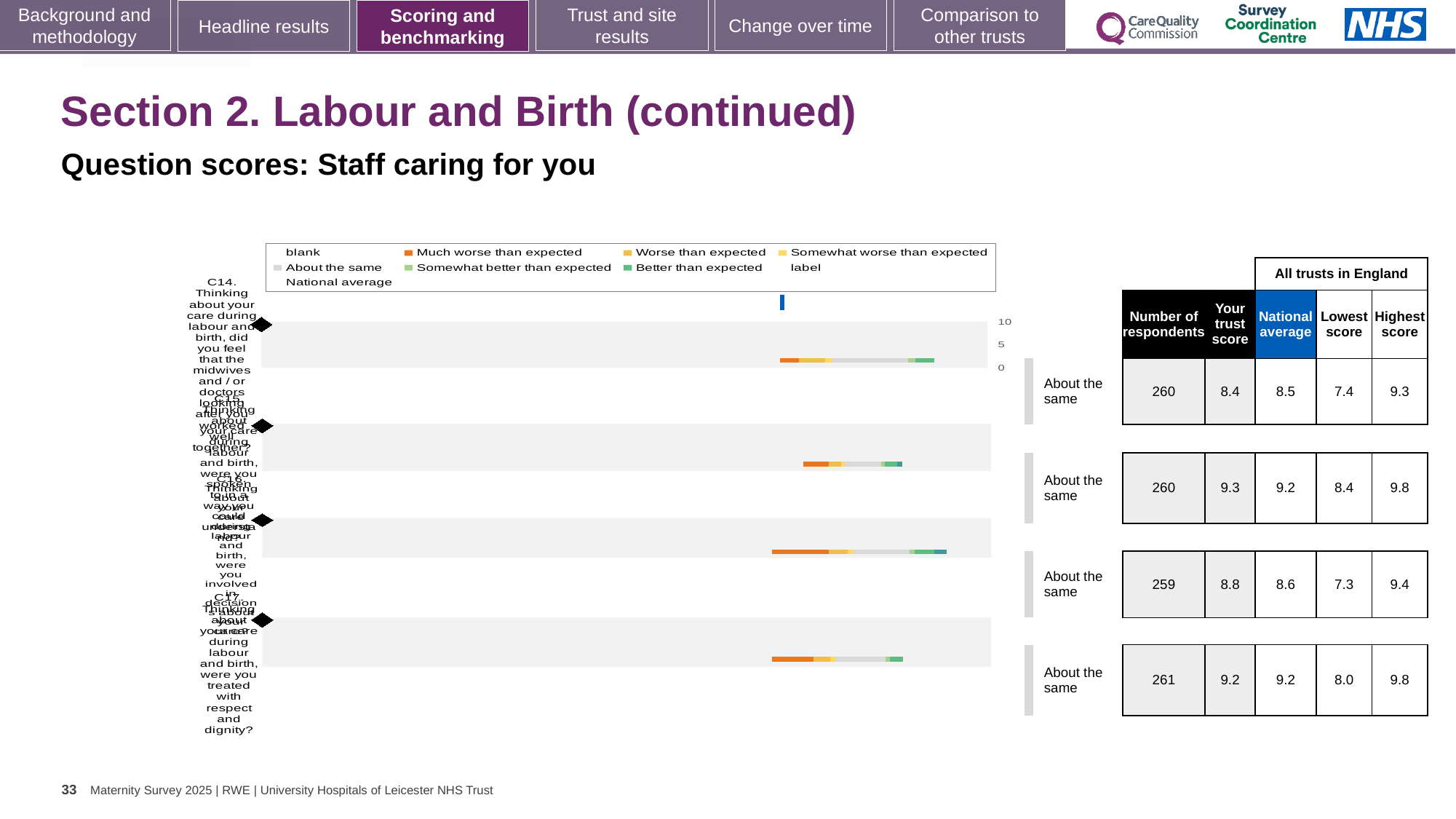
What kind of chart is shown on the slide? bar chart What benchmark category is shown for every question row on the slide? About the same How many question rows (bars) does the chart show? 4 In the table next to the chart, what is 'Your trust score' for the second row (C15)? 9.3 In the table next to the chart, is 'Your trust score' for the third row (C16) larger or smaller than its national average? larger In the table next to the chart, what is the lowest score for the fourth row (C17)? 8.0 In the table next to the chart, what is the difference between the highest score and the lowest score for the first row (C14)? 1.9 In the table next to the chart, what is the number of respondents for the first row (C14)? 260 In the table next to the chart, what is the national average for the third row (C16)? 8.6 In the table next to the chart, which row has the lowest 'Your trust score'? the first row (C14), 8.4 What is the highest value shown on the chart's axis? 10 In the chart legend, which colour represents 'Much worse than expected'? orange